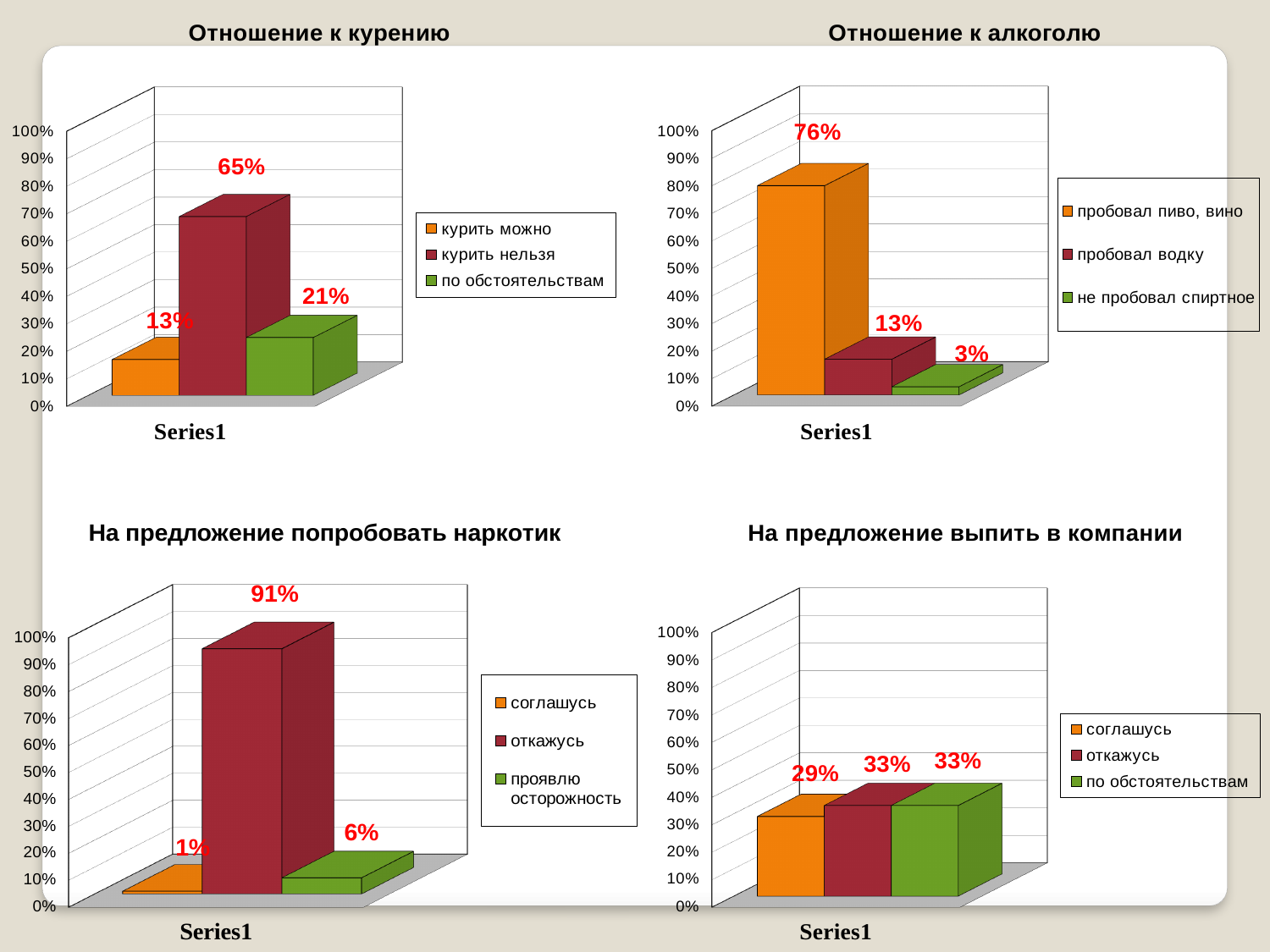
What kind of chart is the one titled "Отношение к алкоголю"? bar chart In the chart titled "На предложение попробовать наркотик", what is the value for "откажусь"? 91% In the chart titled "Отношение к курению", which legend entry has the lowest value? курить можно In the chart titled "На предложение выпить в компании", what is the value for "соглашусь"? 29% In the chart titled "На предложение попробовать наркотик", what is the value for "соглашусь"? 1% In the chart titled "Отношение к алкоголю", which is larger: "пробовал водку" or "не пробовал спиртное"? пробовал водку In the chart titled "Отношение к курению", what is the value for "курить нельзя"? 65% In the chart titled "Отношение к алкоголю", what is the value for "не пробовал спиртное"? 3% In the chart titled "На предложение выпить в компании", how many entries does the legend list? 3 In the chart titled "На предложение попробовать наркотик", what is the difference between "откажусь" and "проявлю осторожность"? 85% In the chart titled "Отношение к алкоголю", what is the value for "пробовал пиво, вино"? 76% In the chart titled "Отношение к курению", what is the difference between "курить нельзя" and "по обстоятельствам"? 44%